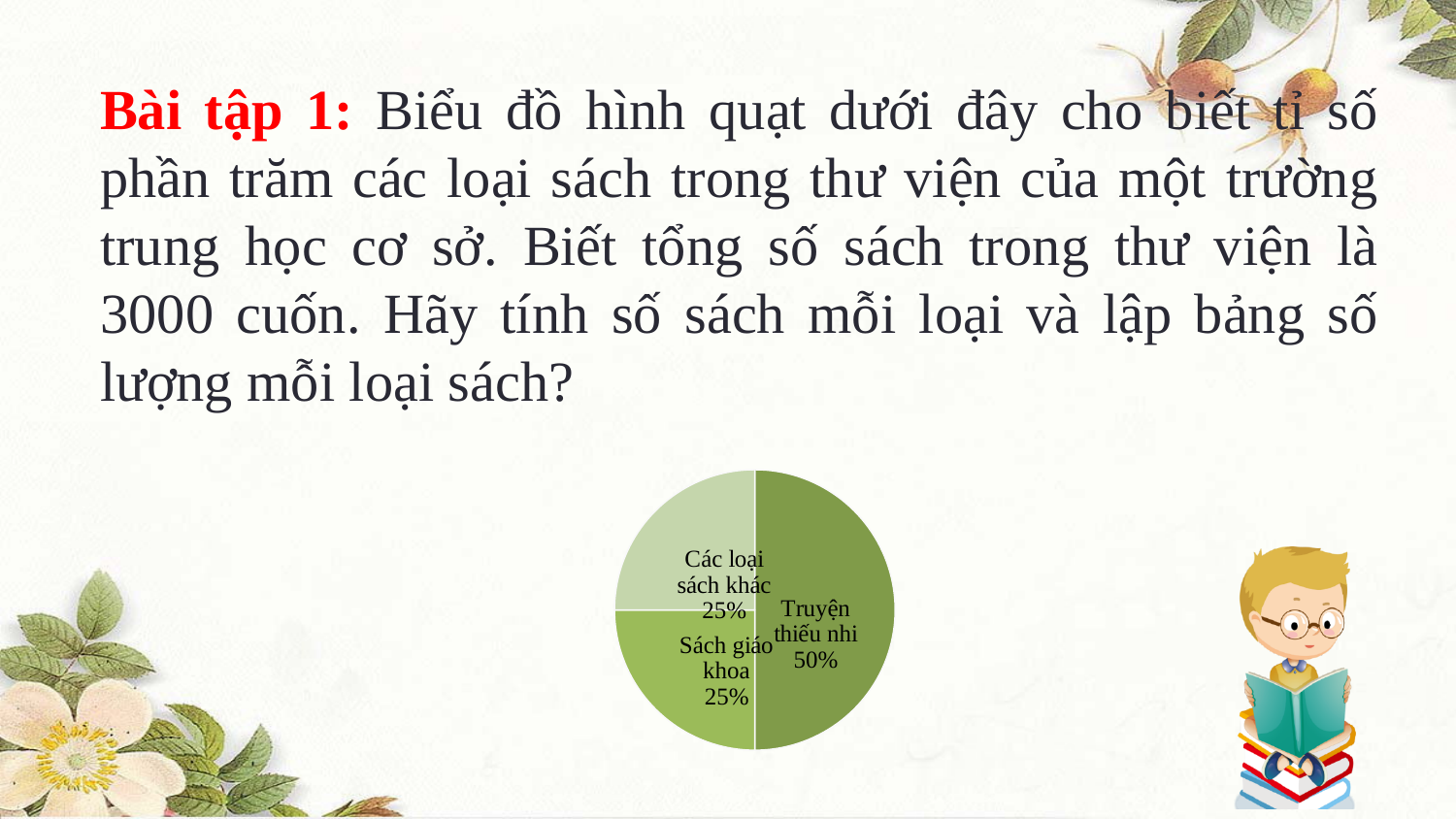
What kind of chart is shown on the slide? pie chart What is the difference in percentage points between Truyện thiếu nhi and Các loại sách khác? 25 How many slices does the pie chart have? 3 What percentage does the pie chart show for Các loại sách khác? 25% Which is larger in the pie chart, Truyện thiếu nhi or Sách giáo khoa? Truyện thiếu nhi What share of the pie does Truyện thiếu nhi take? 50% What percentage does the pie chart show for Truyện thiếu nhi? 50% Which slice of the pie chart is the darkest green? Truyện thiếu nhi Which category has the largest slice of the pie chart? Truyện thiếu nhi What is the combined share of Sách giáo khoa and Các loại sách khác? 50% What percentage does the pie chart show for Sách giáo khoa? 25%